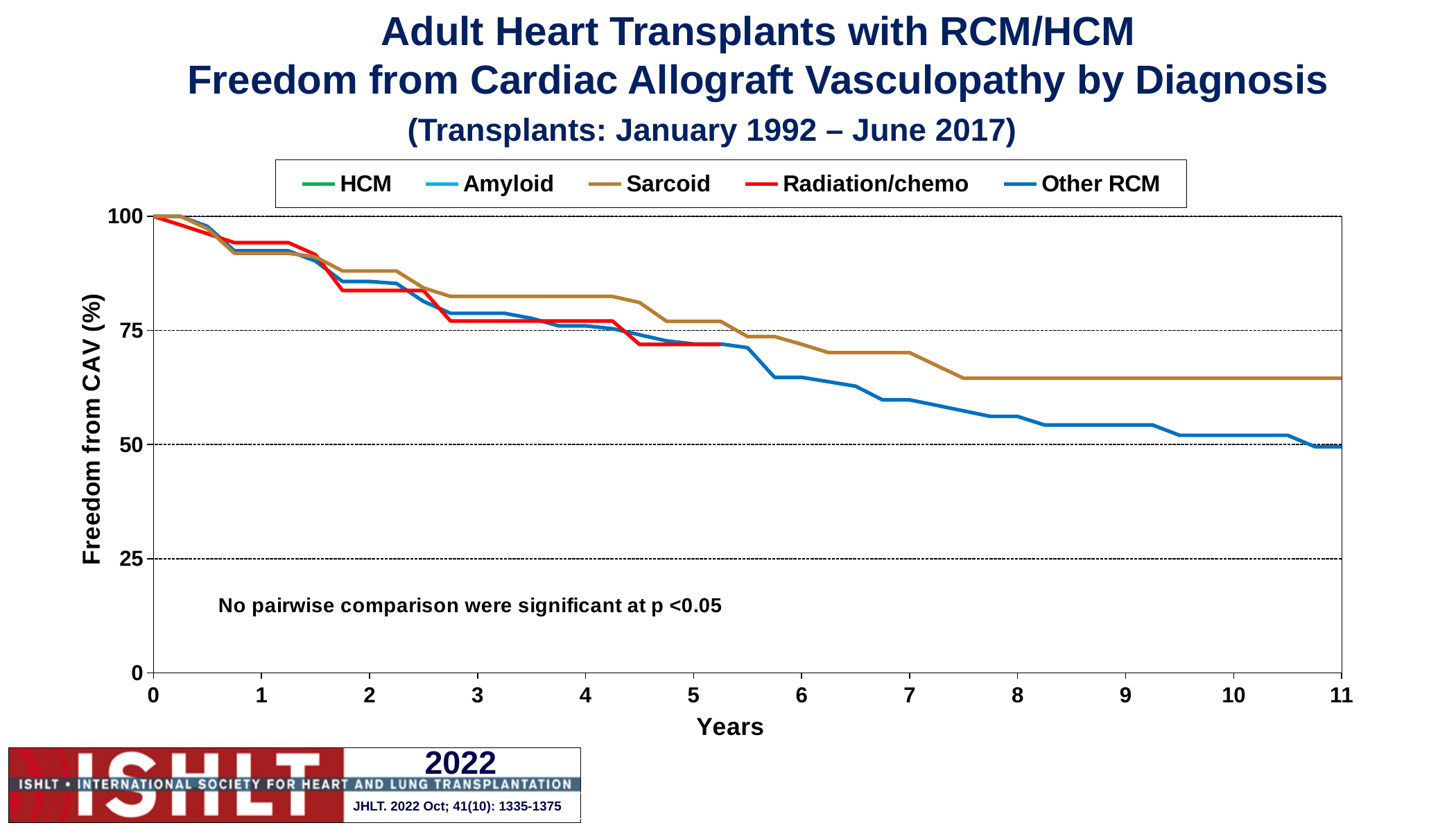
What kind of chart is shown on the slide? Line chart What note is printed inside the plot area? No pairwise comparison were significant at p <0.05 Is the value for Sarcoid at 11 years greater or less than 50? greater What is the label of the y axis? Freedom from CAV (%) Does the Other RCM line rise or fall as years increase? Fall How many series does the legend list? 5 Which series has the highest freedom from CAV at 11 years? Sarcoid Is the value for Sarcoid at 3 years greater or less than 75? greater Is the value for Other RCM at 11 years greater or less than 75? less At 9 years, which is higher: Sarcoid or Other RCM? Sarcoid